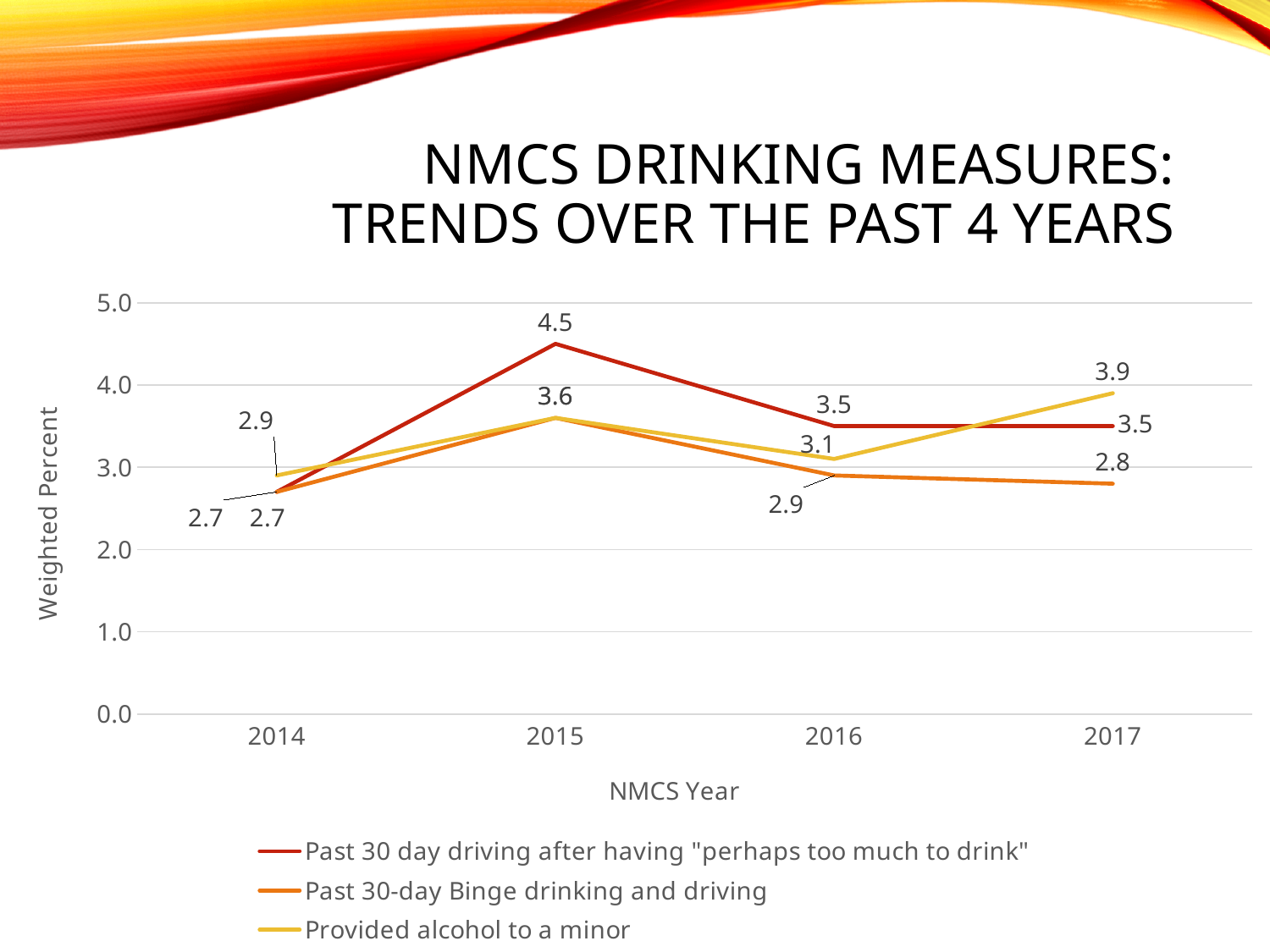
Does the value for "Past 30-day Binge drinking and driving" rise or fall from 2015 to 2017? Fall What type of chart is shown on the slide? Line chart What is the label on the y axis? Weighted Percent What is the value for "Provided alcohol to a minor" in 2017? 3.9 How many years are shown on the x axis? 4 In which year does "Past 30 day driving after having 'perhaps too much to drink'" reach its highest value? 2015 How many series does the legend list? 3 What is the value for "Past 30-day Binge drinking and driving" in 2016? 2.9 What is the difference between the 2015 and 2016 values for "Past 30 day driving after having 'perhaps too much to drink'"? 1.0 What is the value for "Past 30 day driving after having 'perhaps too much to drink'" in 2015? 4.5 Which is larger in 2017: "Past 30-day Binge drinking and driving" or "Provided alcohol to a minor"? Provided alcohol to a minor Which series has the highest value in 2017? Provided alcohol to a minor